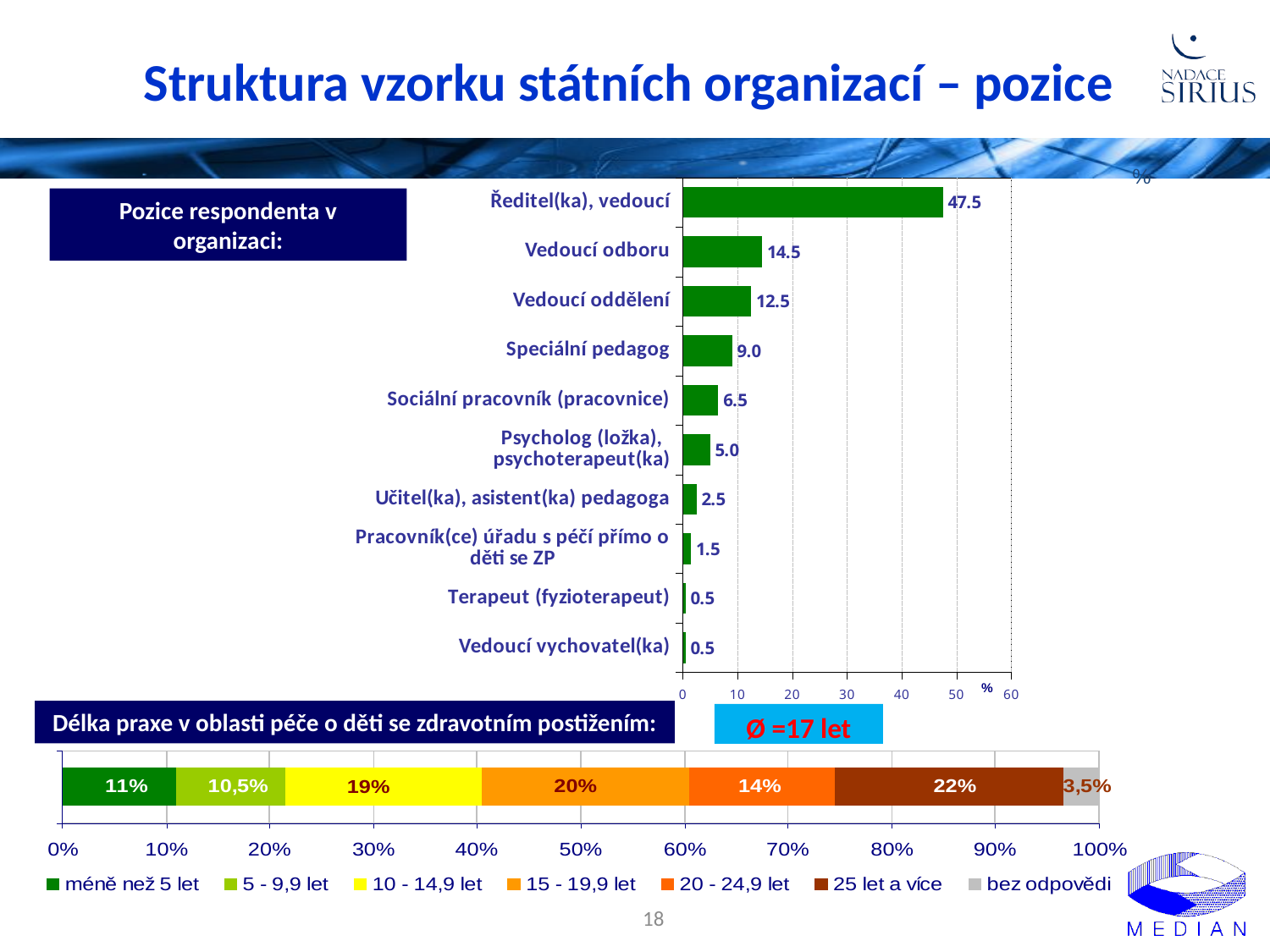
In the top chart (Pozice respondenta v organizaci), how many positions are listed? 10 In the bottom chart (Délka praxe v oblasti péče o děti se zdravotním postižením), what is the share for 5 - 9,9 let? 10,5% In the top chart (Pozice respondenta v organizaci), what is the value for Speciální pedagog? 9.0 What kind of chart is the top chart (Pozice respondenta v organizaci)? Bar chart In the bottom chart (Délka praxe v oblasti péče o děti se zdravotním postižením), which category has the smallest share? bez odpovědi In the top chart (Pozice respondenta v organizaci), what is the difference between Vedoucí odboru and Vedoucí oddělení? 2.0 In the bottom chart (Délka praxe v oblasti péče o děti se zdravotním postižením), what is the share for 25 let a více? 22% In the bottom chart (Délka praxe v oblasti péče o děti se zdravotním postižením), how many categories does the legend list? 7 In the top chart (Pozice respondenta v organizaci), which is larger: Sociální pracovník (pracovnice) or Psycholog (ložka), psychoterapeut(ka)? Sociální pracovník (pracovnice) In the top chart (Pozice respondenta v organizaci), which position has the highest value? Ředitel(ka), vedoucí In the top chart (Pozice respondenta v organizaci), what is the value for Ředitel(ka), vedoucí? 47.5 In the top chart (Pozice respondenta v organizaci), is the value for Ředitel(ka), vedoucí greater or less than 40? greater